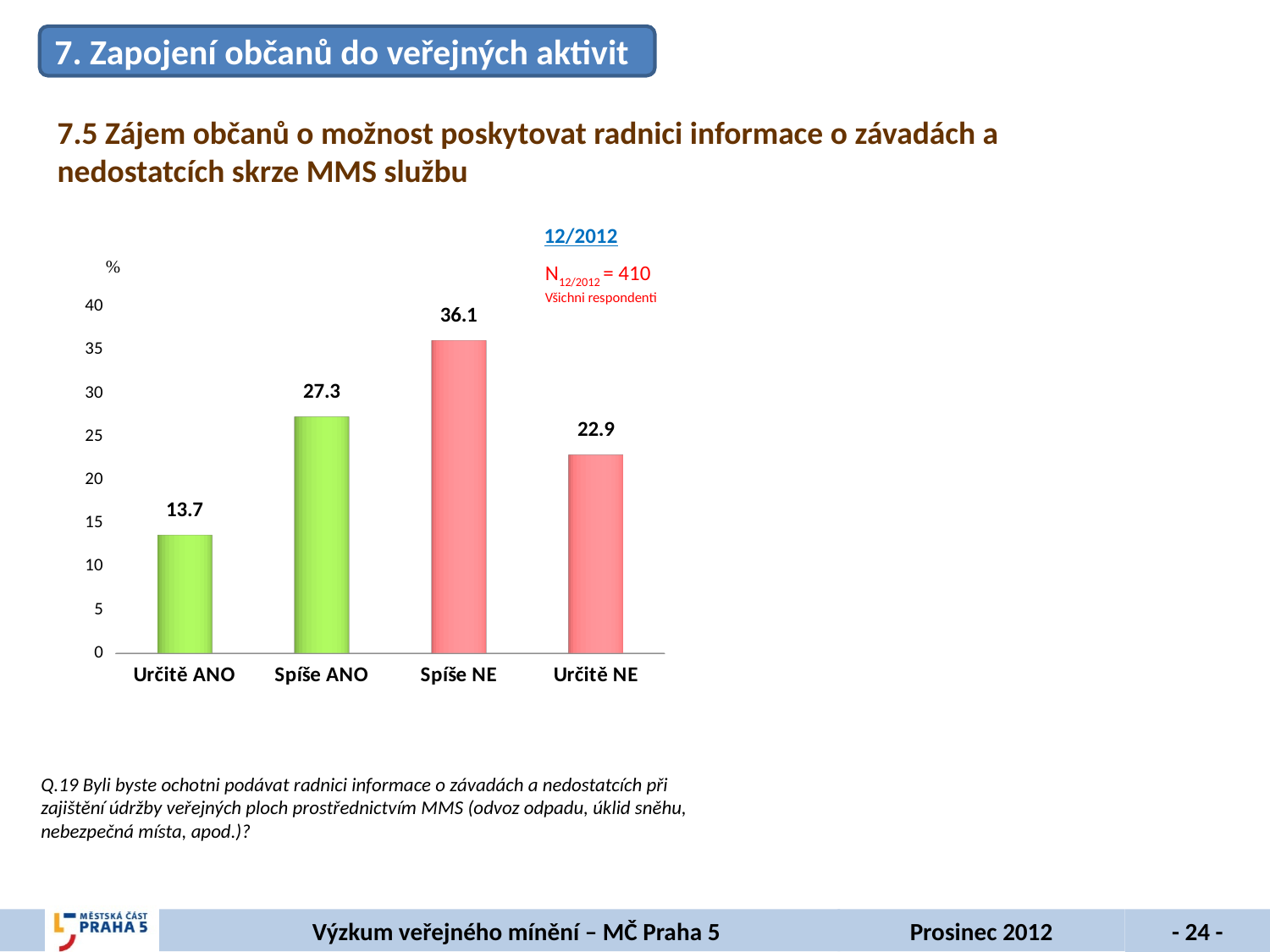
Which category has the lowest value? Určitě ANO What is the value for Určitě NE? 22.9 How many categories are shown on the x axis? 4 What is the number of respondents (N) stated next to the chart? 410 Is the value for Spíše NE greater or less than 35? greater Which is larger, the value for Spíše ANO or the value for Určitě NE? Spíše ANO What is the value for Spíše NE? 36.1 What kind of chart is shown on the slide? bar chart What is the value for Spíše ANO? 27.3 What is the difference between the values for Spíše NE and Určitě NE? 13.2 Which category has the highest value? Spíše NE What is the value for Určitě ANO? 13.7